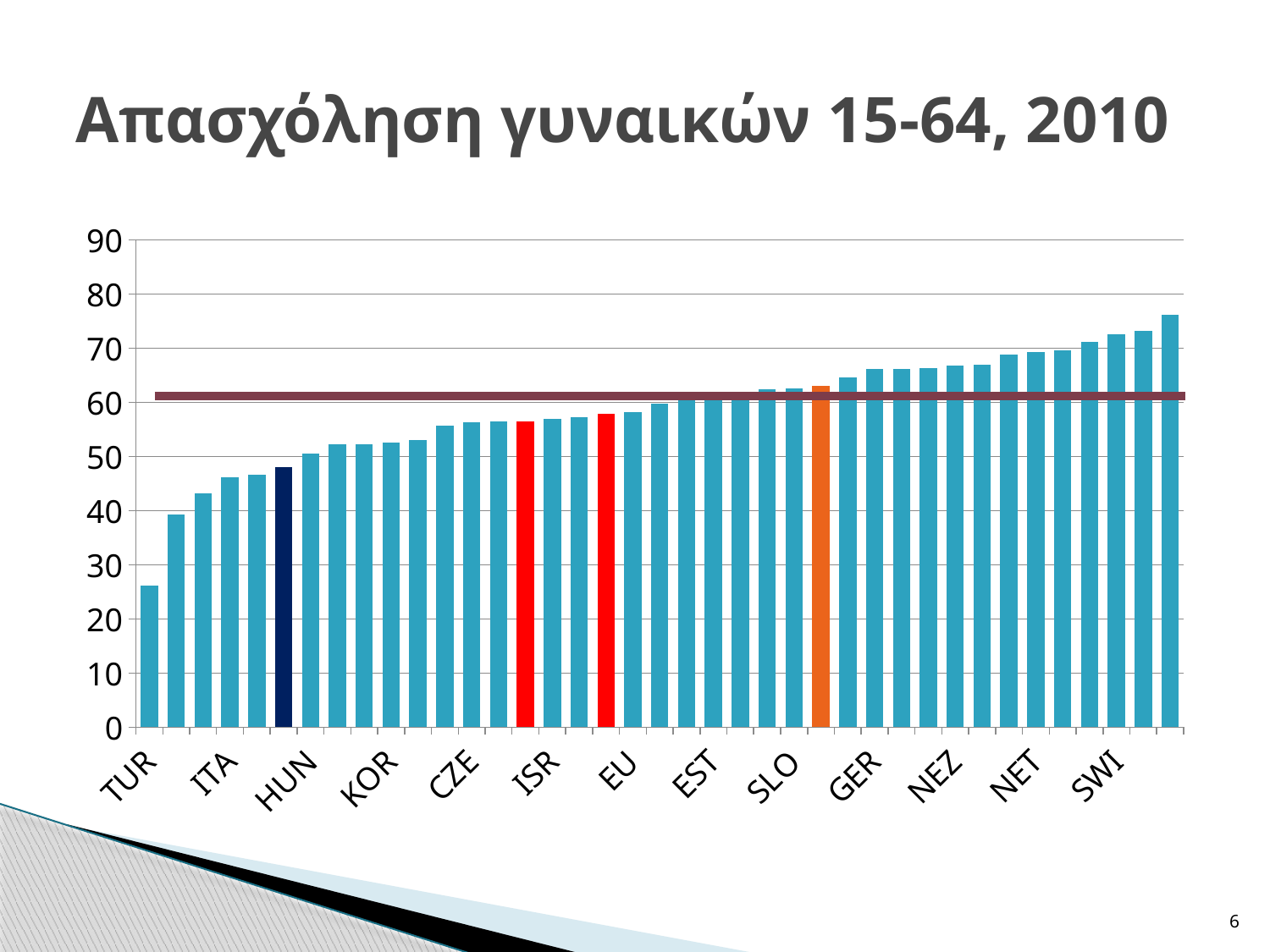
Which labelled country has the lowest value? TUR Is the value for ITA greater or less than 50? less Is the value for KOR greater or less than 60? less What kind of chart is shown on the slide? bar chart Which is larger, the value for ITA or the value for NET? NET Is the value for SWI greater or less than 60? greater What is the title of the chart? Απασχόληση γυναικών 15-64, 2010 Which is larger, the value for TUR or the value for SWI? SWI Do the bar values rise or fall from left to right along the x axis? rise How many country labels are shown on the x axis? 13